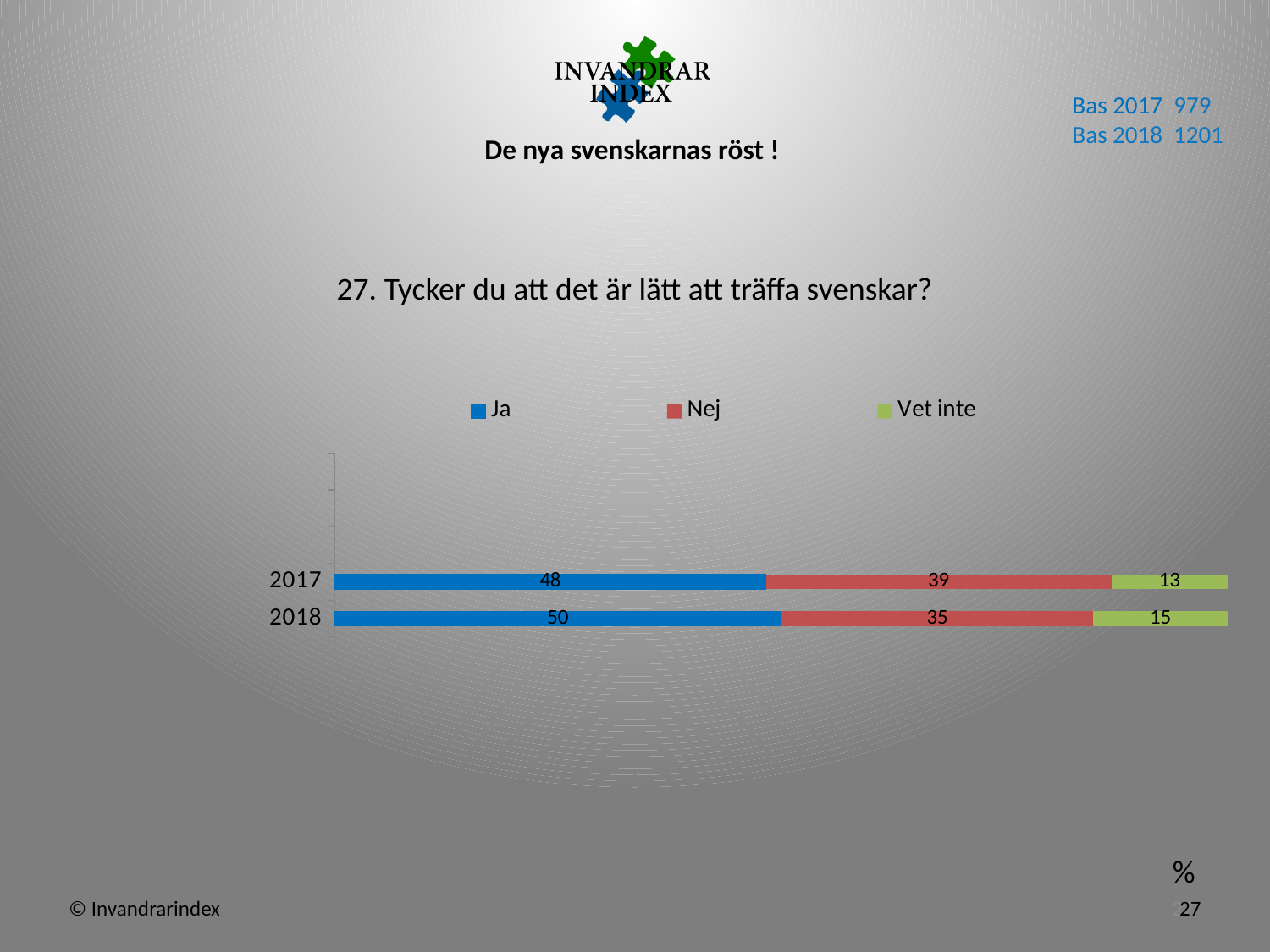
What is the difference between the Nej values for 2017 and 2018? 4 What kind of chart is shown? Stacked bar chart Which year has the lower value for Vet inte? 2017 How many series does the legend list? 3 Which year has the higher value for Nej? 2017 What is the value for Nej in 2018? 35 What is the value for Ja in 2018? 50 How many years are shown on the chart? 2 What is the total of the stacked bar for 2017? 100 What is the value for Ja in 2017? 48 Is the Ja value larger in 2017 or 2018? 2018 What is the value for Vet inte in 2017? 13